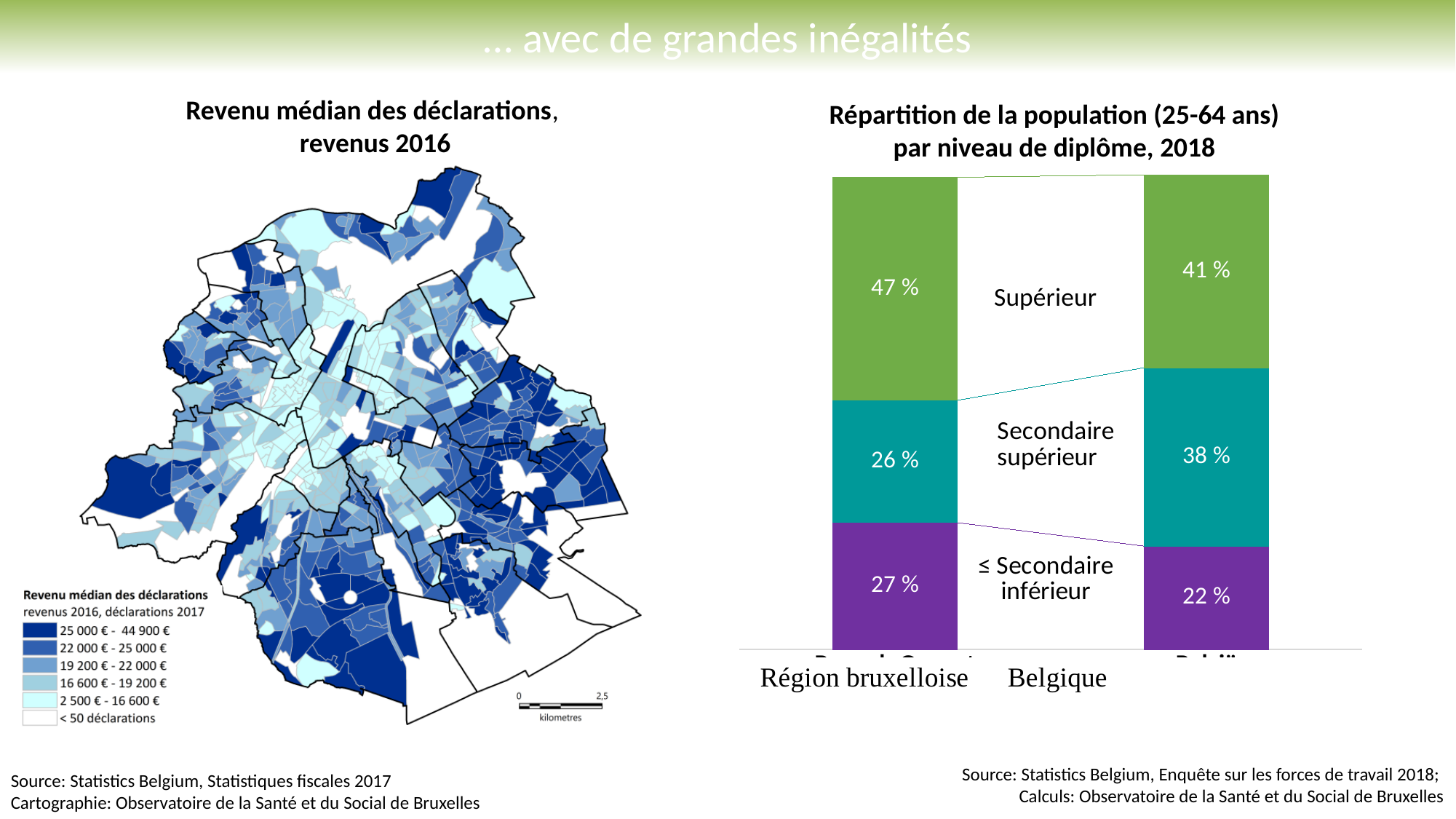
In the chart 'Répartition de la population (25-64 ans) par niveau de diplôme, 2018', how many regions (bars) are compared? 2 In the chart 'Répartition de la population (25-64 ans) par niveau de diplôme, 2018', how many percentage points higher is the 'Secondaire supérieur' share in Belgique than in the Région bruxelloise? 12 In the chart 'Répartition de la population (25-64 ans) par niveau de diplôme, 2018', what is the value for '≤ Secondaire inférieur' in the Région bruxelloise? 27 % What kind of chart is 'Répartition de la population (25-64 ans) par niveau de diplôme, 2018'? Stacked bar chart In the chart 'Répartition de la population (25-64 ans) par niveau de diplôme, 2018', what is the value for '≤ Secondaire inférieur' in Belgique? 22 % In the chart 'Répartition de la population (25-64 ans) par niveau de diplôme, 2018', which diploma level has the smallest share in Belgique? ≤ Secondaire inférieur In the chart 'Répartition de la population (25-64 ans) par niveau de diplôme, 2018', which diploma level has the largest share in the Région bruxelloise? Supérieur In the chart 'Répartition de la population (25-64 ans) par niveau de diplôme, 2018', how many diploma levels are shown in each bar? 3 In the chart 'Répartition de la population (25-64 ans) par niveau de diplôme, 2018', which has the larger 'Supérieur' share: Région bruxelloise or Belgique? Région bruxelloise In the chart 'Répartition de la population (25-64 ans) par niveau de diplôme, 2018', what is the difference in the 'Supérieur' share between the Région bruxelloise and Belgique? 6 percentage points In the chart 'Répartition de la population (25-64 ans) par niveau de diplôme, 2018', what share of the Belgique population has a 'Secondaire supérieur' diploma? 38 % In the chart 'Répartition de la population (25-64 ans) par niveau de diplôme, 2018', what share of the Région bruxelloise population has a 'Supérieur' diploma? 47 %